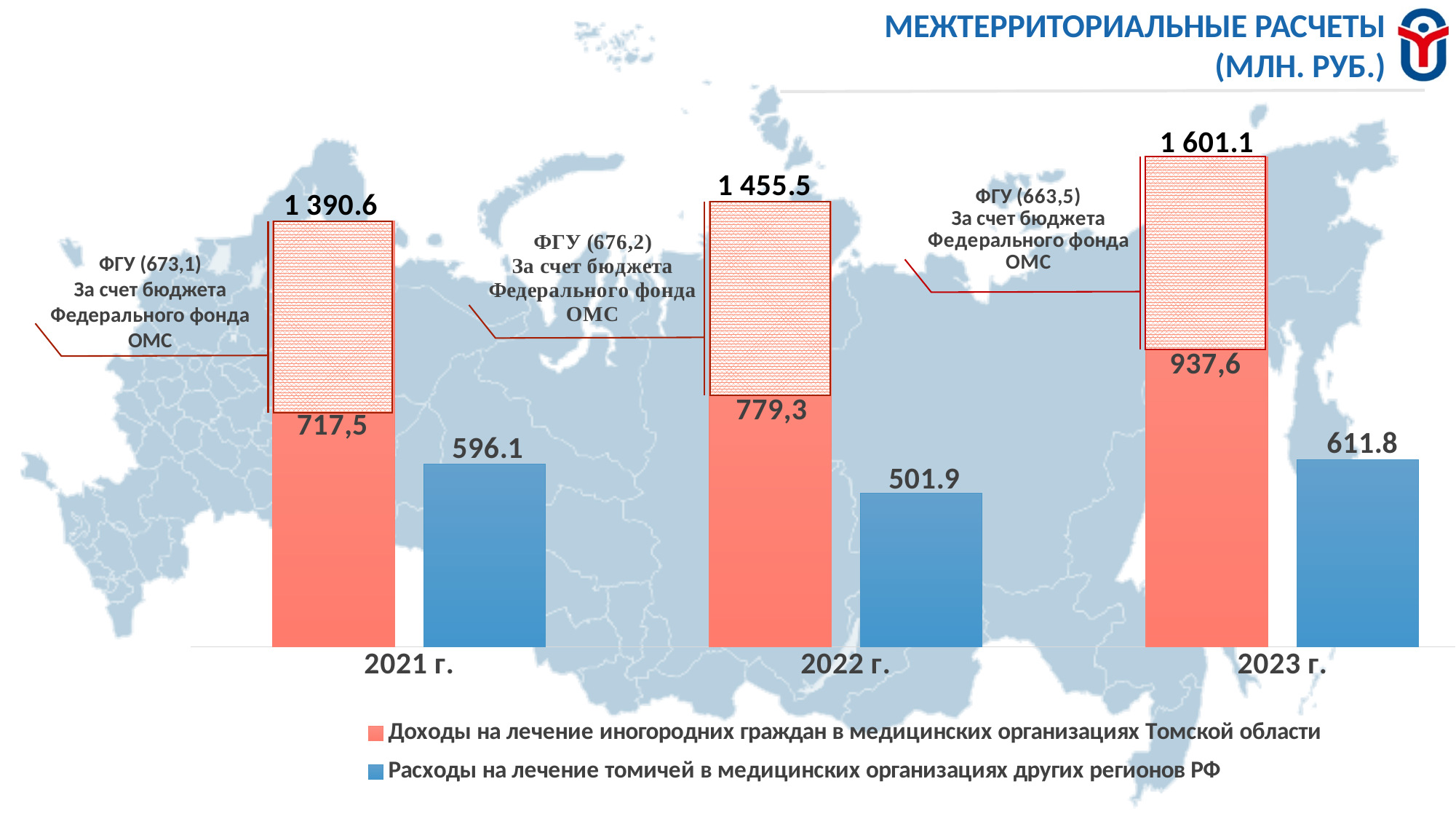
In which year is the total above the red bar (Доходы) the highest? 2023 г. What total is printed above the red bar for 2023 г.? 1 601.1 In which year is the blue bar (Расходы) the lowest? 2022 г. What kind of chart is shown on the slide? Bar chart What is the ФГУ amount noted for 2021 г.? 673,1 How many series does the legend list? 2 What is the value of the blue bar (Расходы на лечение томичей в медицинских организациях других регионов РФ) for 2021 г.? 596.1 What is the value of the blue bar (Расходы на лечение томичей в медицинских организациях других регионов РФ) for 2022 г.? 501.9 What is the difference between the blue bar values for 2023 г. and 2022 г.? 109.9 Which is larger in 2021 г.: the red bar total (1 390.6) or the blue bar (596.1)? The red bar total (1 390.6) How many years are shown on the x axis? 3 What value is printed on the solid red part of the bar for 2022 г.? 779,3